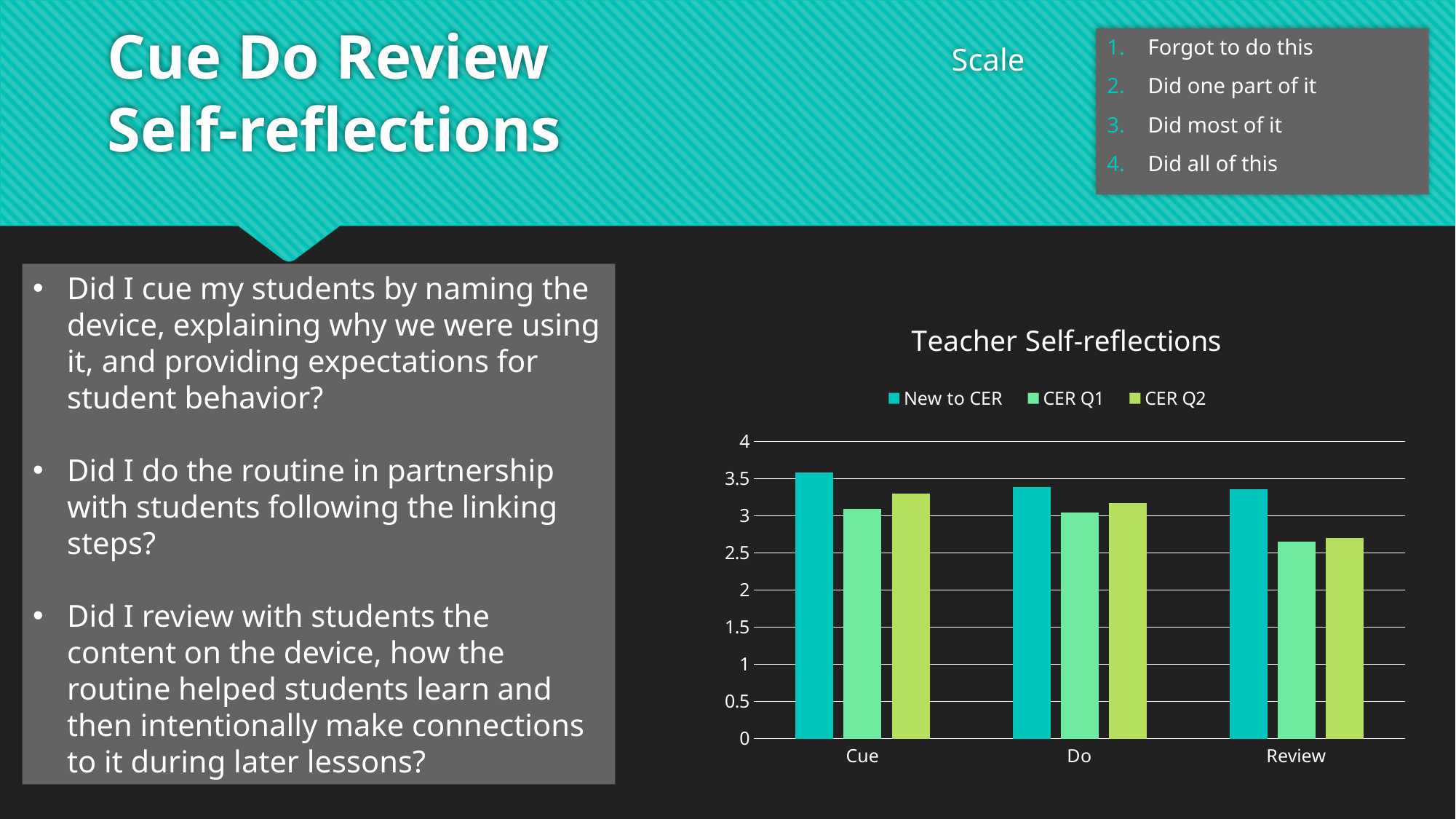
What kind of chart is shown under the title "Teacher Self-reflections"? bar chart What are the three series named in the legend of the Teacher Self-reflections chart? New to CER, CER Q1, CER Q2 Is the CER Q1 value for Review greater or less than 3? less For which category is the CER Q1 value lowest? Review For which category is the CER Q2 value highest? Cue Is the New to CER value for Cue greater or less than 3? greater How many categories are shown on the x axis of the Teacher Self-reflections chart? 3 For the Review category, which is larger: New to CER or CER Q2? New to CER What is the title of the chart on the slide? Teacher Self-reflections How many series does the legend of the Teacher Self-reflections chart list? 3 Do the CER Q1 values rise or fall from Cue to Review? fall For which category is the New to CER value highest? Cue